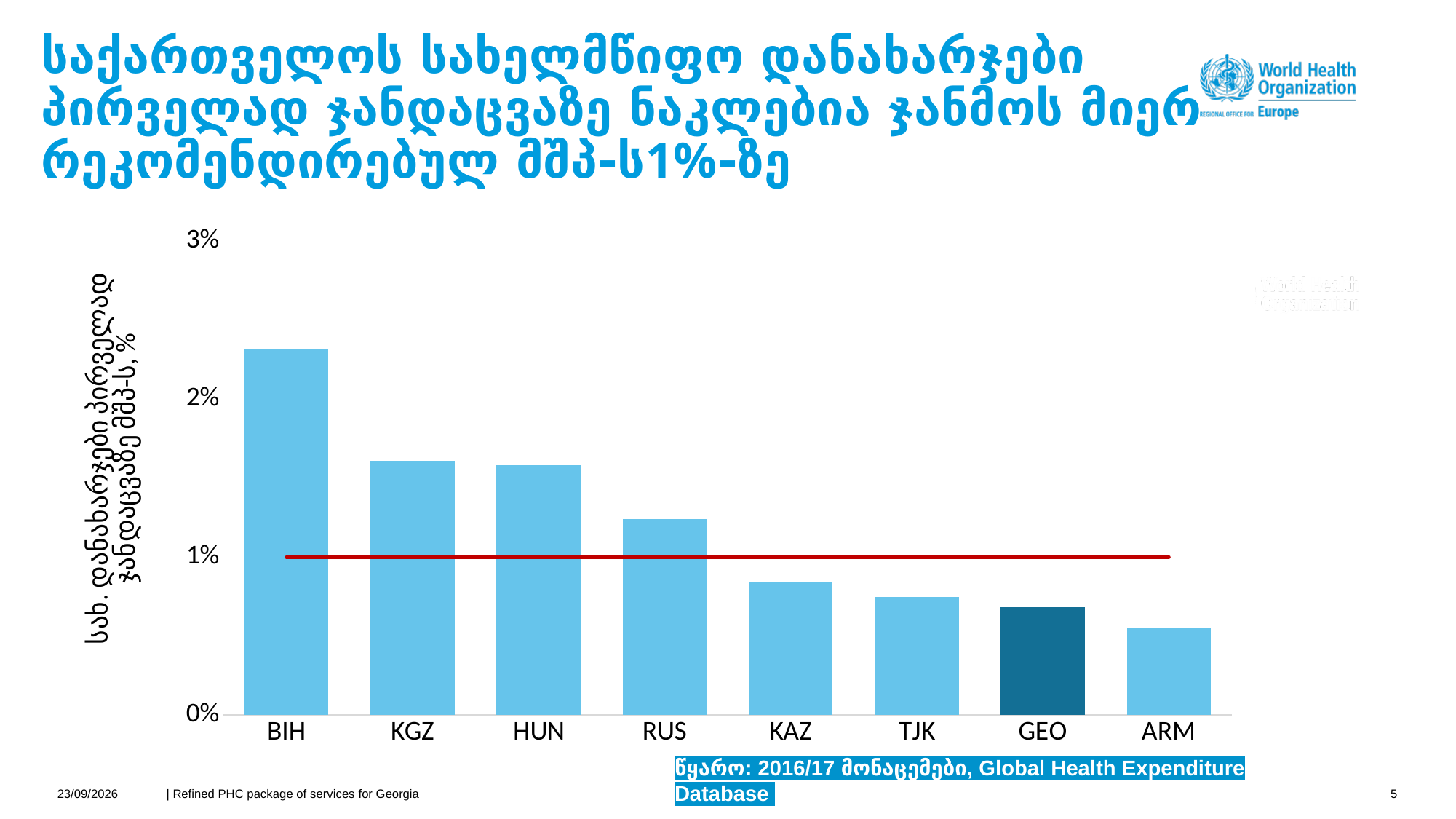
What kind of chart is shown on the slide? bar chart Which country has the lowest bar in the chart? ARM Which country has the highest bar in the chart? BIH Is the value for GEO greater or less than 1%? less Which country's bar is shown in a darker blue than the others? GEO Is the value for KAZ greater or less than 1%? less Do the bar values rise or fall from left to right along the x axis? fall Which is larger, the value for GEO or the value for ARM? GEO Is the value for RUS greater or less than 1%? greater Which is larger, the value for RUS or the value for TJK? RUS How many countries are shown on the x axis of the chart? 8